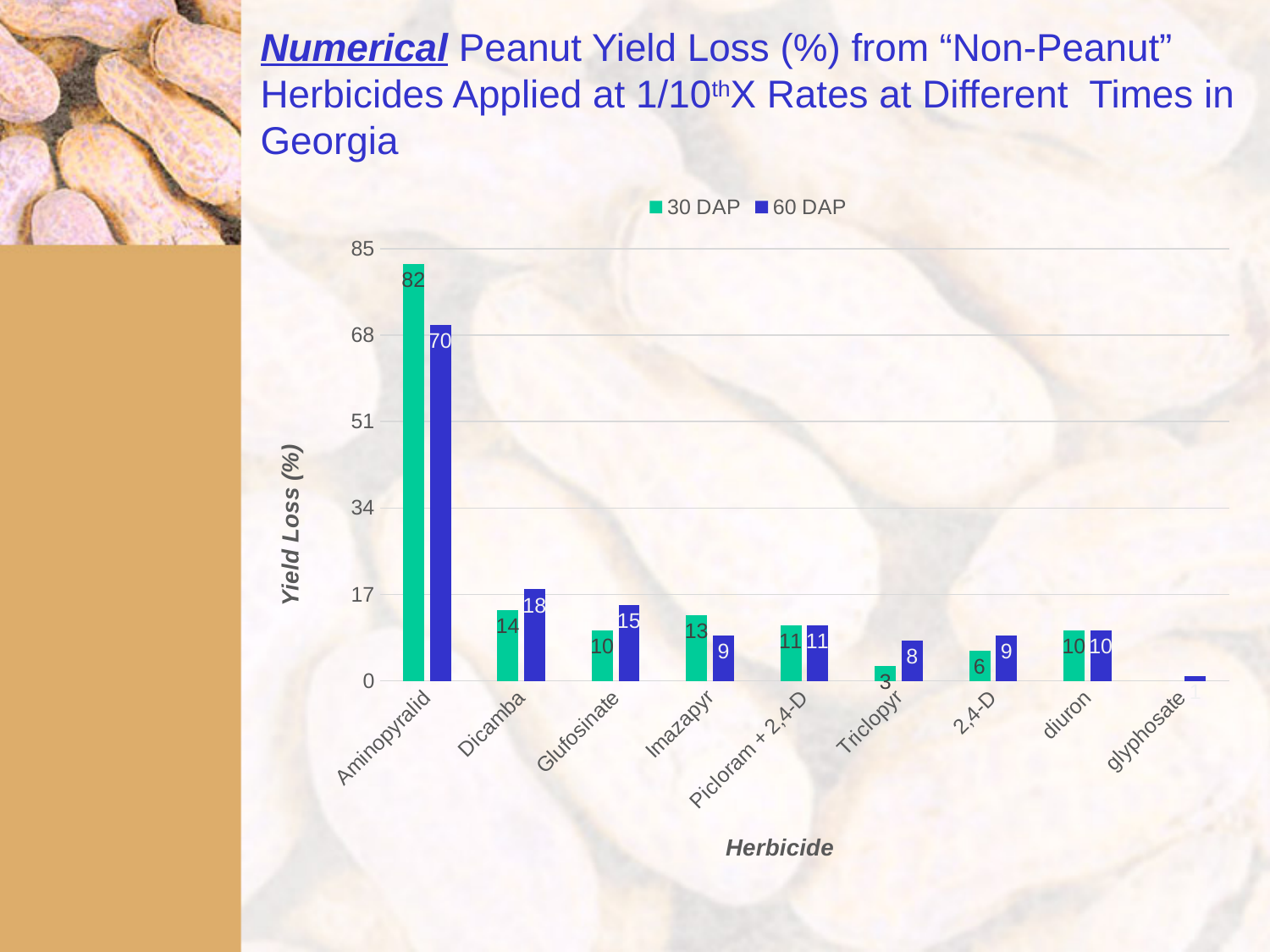
What is the title of the y axis? Yield Loss (%) What kind of chart is shown on the slide? bar chart What is the 60 DAP yield loss value for Dicamba? 18 How many series does the legend list? 2 Is the 60 DAP value for Aminopyralid greater or less than 51? greater Which herbicide has the highest 30 DAP yield loss? Aminopyralid What is the 60 DAP yield loss value for Triclopyr? 8 How many herbicides are shown on the x axis? 9 Which herbicide has the lowest 60 DAP yield loss? glyphosate What is the 30 DAP yield loss value for Aminopyralid? 82 What is the difference between the 30 DAP and 60 DAP values for Aminopyralid? 12 For Glufosinate, which series has the larger value, 30 DAP or 60 DAP? 60 DAP